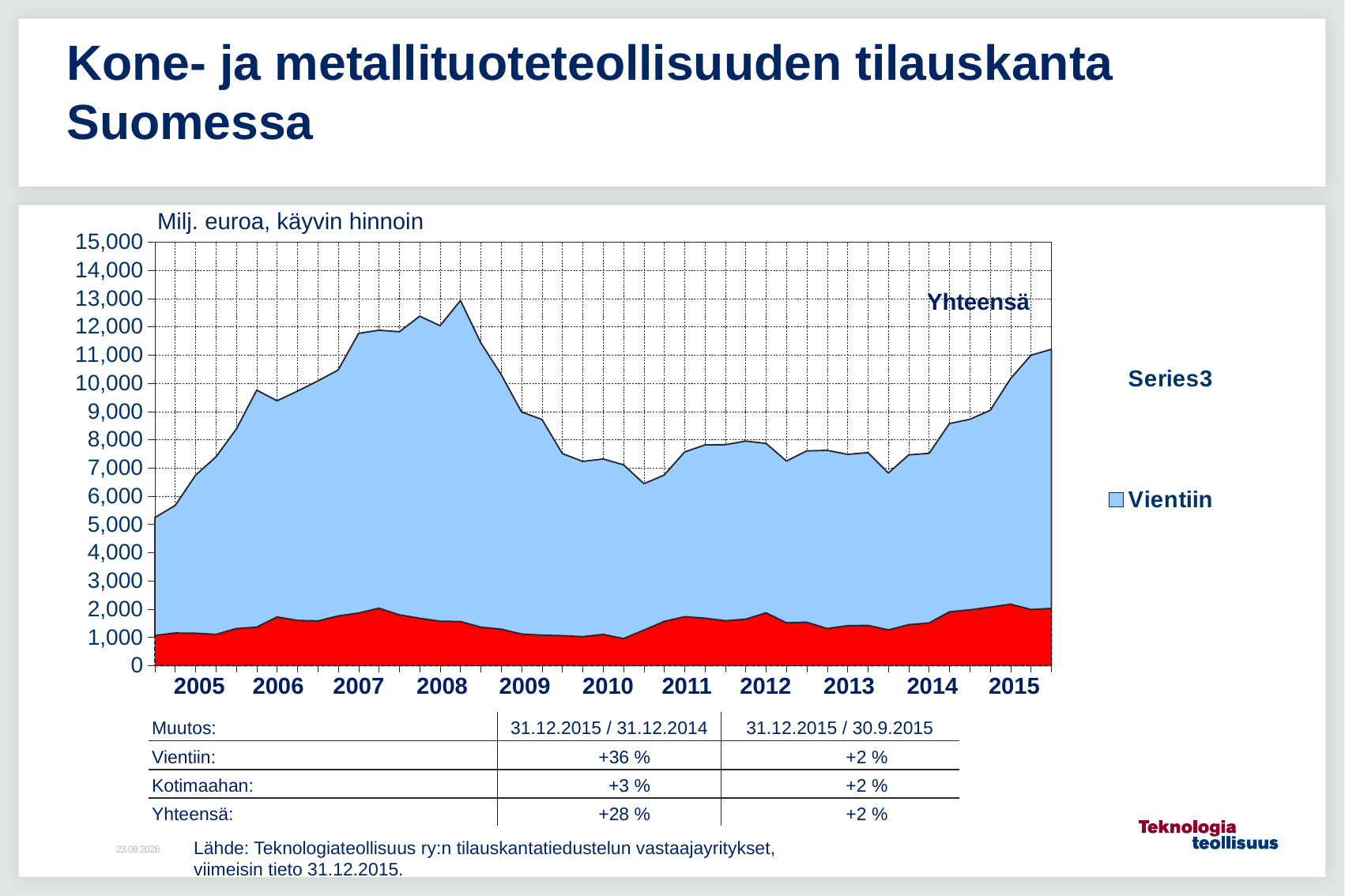
What kind of chart is shown on the slide? area chart How many series does the chart legend list? 2 How many years are labelled on the x axis of the chart? 11 In which year does the total (Yhteensä) reach its highest peak? 2008 In which year is the total (Yhteensä) at its lowest level? 2005 Is the peak total value in 2008 greater or less than 12,000? greater Is the total value at the end of 2015 greater or less than 10,000? greater Is the total value at the start of 2005 greater or less than 6,000? less Does the total (Yhteensä) rise or fall from its 2008 peak to 2010? fall What unit label is shown above the chart? Milj. euroa, käyvin hinnoin Which legend entry is shown with the light blue colour? Vientiin